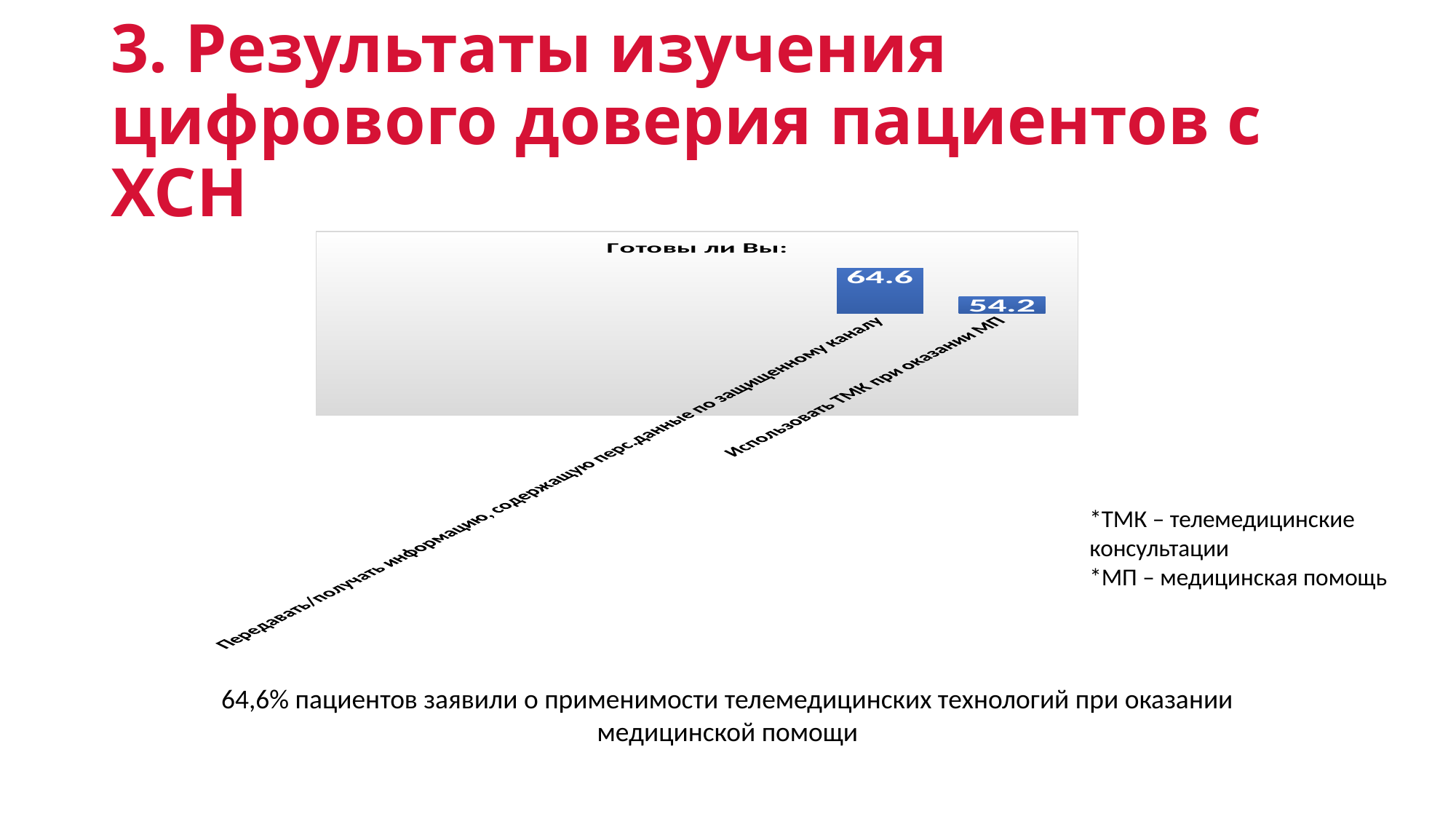
What kind of chart is shown on the slide? Bar chart What is the value shown for "Использовать ТМК при оказании МП"? 54.2 What is the difference between the values for "Передавать/получать информацию, содержащую перс.данные по защищенному каналу" and "Использовать ТМК при оказании МП"? 10.4 Which category has the highest value in the chart? Передавать/получать информацию, содержащую перс.данные по защищенному каналу What colour are the bars in the chart? Blue How many categories are plotted in the chart? 2 Which is larger: the value for "Использовать ТМК при оказании МП" or the value for "Передавать/получать информацию, содержащую перс.данные по защищенному каналу"? Передавать/получать информацию, содержащую перс.данные по защищенному каналу What is the title of the chart? Готовы ли Вы: Which category has the lowest value in the chart? Использовать ТМК при оказании МП What is the value shown for "Передавать/получать информацию, содержащую перс.данные по защищенному каналу"? 64.6